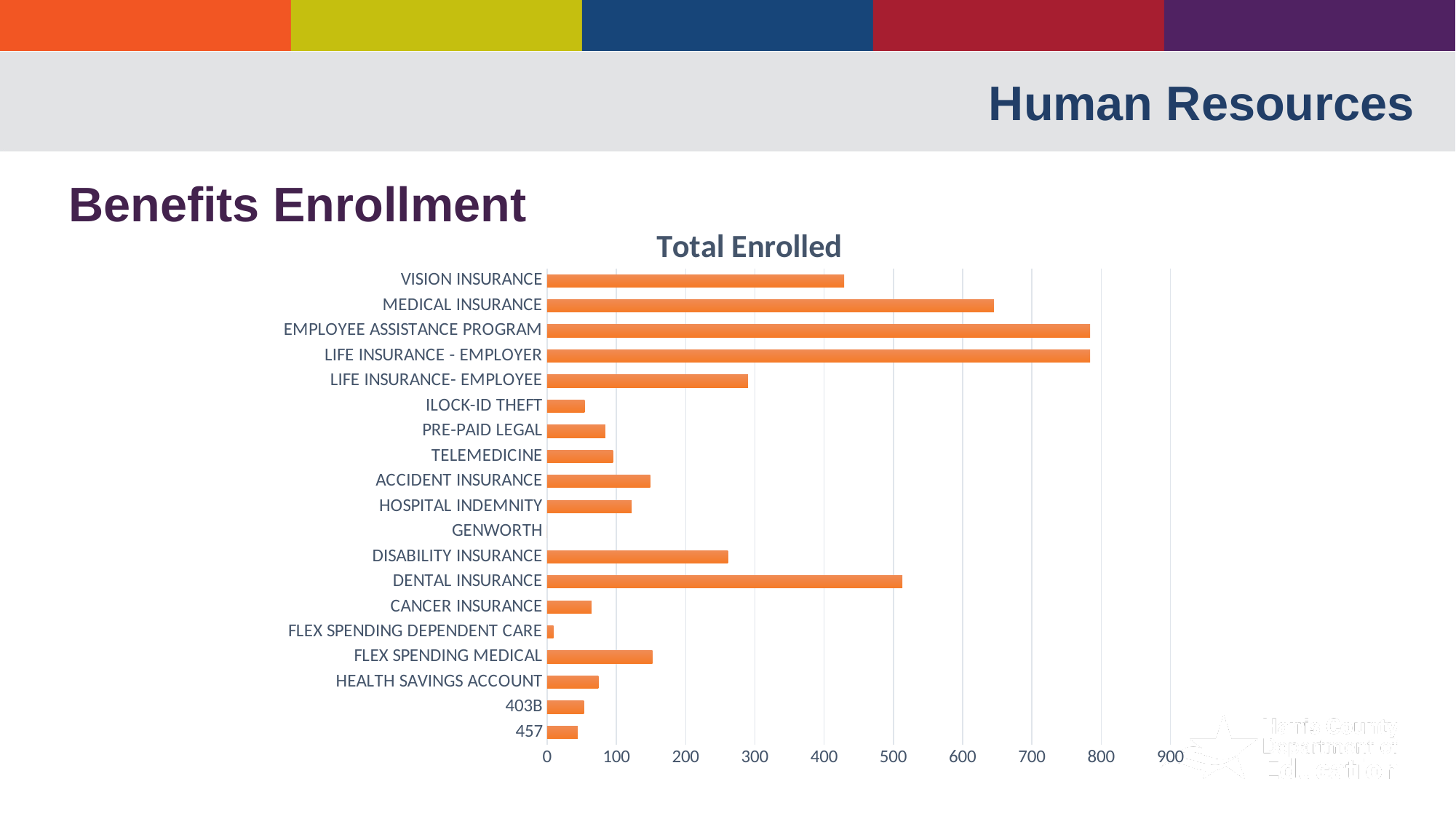
Is the value for VISION INSURANCE greater or less than 400? greater Which has a larger value, VISION INSURANCE or LIFE INSURANCE- EMPLOYEE? VISION INSURANCE Is the value for DENTAL INSURANCE greater or less than 500? greater Is the value for MEDICAL INSURANCE greater or less than 600? greater What colour are the bars in the chart? orange How many categories are listed on the chart's vertical axis? 19 Which has a larger value, MEDICAL INSURANCE or DENTAL INSURANCE? MEDICAL INSURANCE What kind of chart is shown on the slide? bar chart Which category shows no visible bar on the chart? GENWORTH What is the title of the chart? Total Enrolled